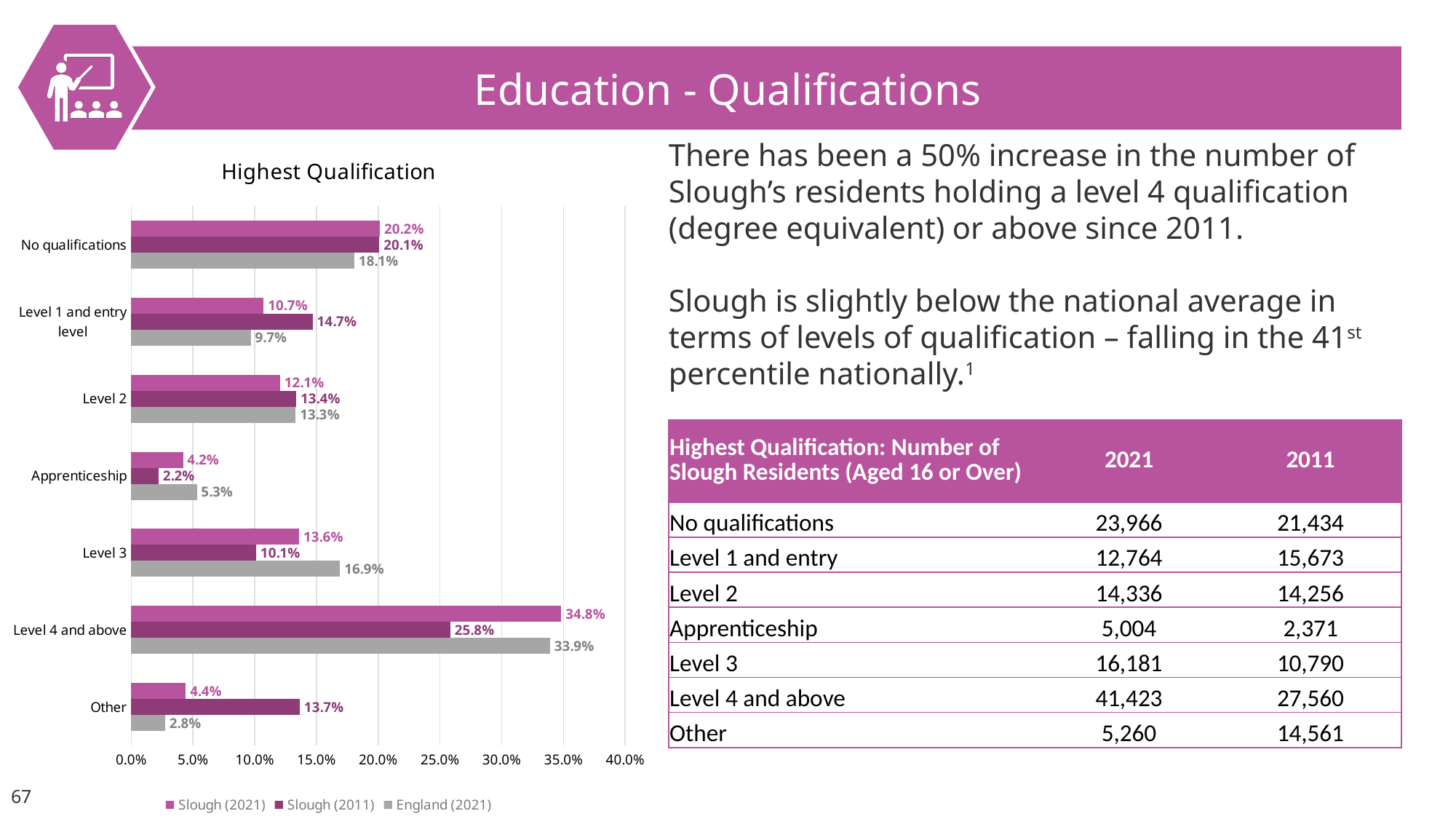
What is the difference between the Slough (2021) and Slough (2011) values for Level 4 and above? 9.0% Which is larger for Level 3: Slough (2021) or England (2021)? England (2021) What is the England (2021) value for No qualifications? 18.1% Which category has the lowest England (2021) value? Other What is the Slough (2011) value for Apprenticeship? 2.2% What type of chart is shown on the slide? Bar chart Is the Slough (2011) value for Other greater or less than 10.0%? greater What is the Slough (2021) value for Level 4 and above? 34.8% How many series does the chart legend list? 3 How many qualification categories are shown on the chart? 7 Which category has the highest Slough (2021) value? Level 4 and above What is the title of the chart? Highest Qualification